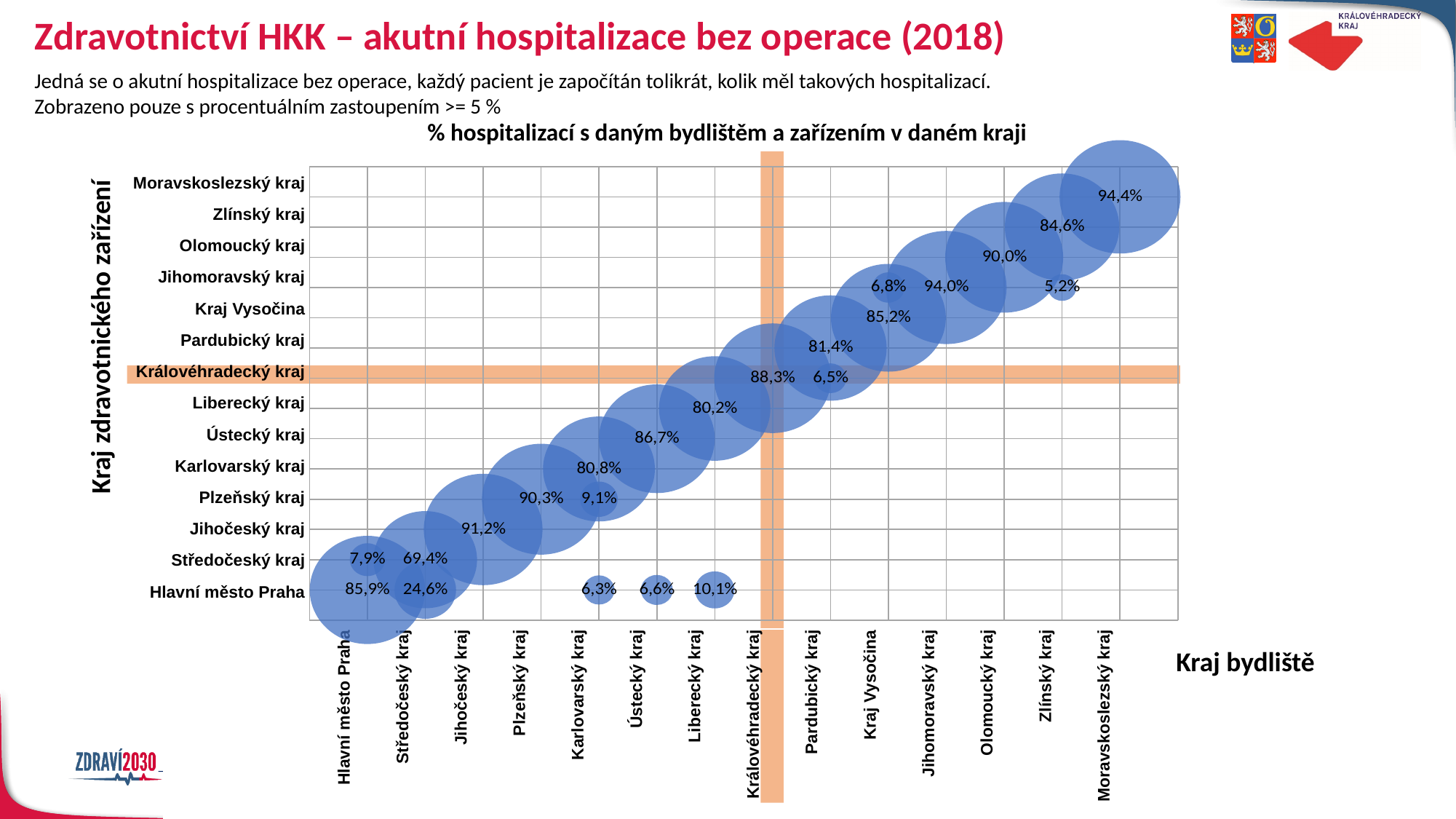
Which is larger: the share of Hlavní město Praha residents hospitalised in Praha, or the share of Středočeský kraj residents hospitalised in Středočeský kraj? Hlavní město Praha residents hospitalised in Praha (85,9%) What is the value for patients residing in Liberecký kraj who were hospitalised in Hlavní město Praha? 10,1% What is the value for patients residing in Středočeský kraj who were hospitalised in Hlavní město Praha? 24,6% What type of chart is shown on the slide? Bubble chart Which region of residence has the highest share of hospitalisations within its own region? Moravskoslezský kraj What percentage of patients residing in Pardubický kraj were hospitalised in a facility in Královéhradecký kraj? 6,5% What percentage of patients residing in Královéhradecký kraj were hospitalised in a facility in Královéhradecký kraj? 88,3% What is the difference between the value for Jihomoravský kraj residents hospitalised in Jihomoravský kraj (94,0%) and Zlínský kraj residents hospitalised in Zlínský kraj (84,6%)? 9,4 percentage points How many regions of residence are listed on the x axis? 14 What is the smallest percentage value labelled on the chart? 5,2% What is the title of the chart? % hospitalizací s daným bydlištěm a zařízením v daném kraji How many labelled bubbles are shown on the chart? 23